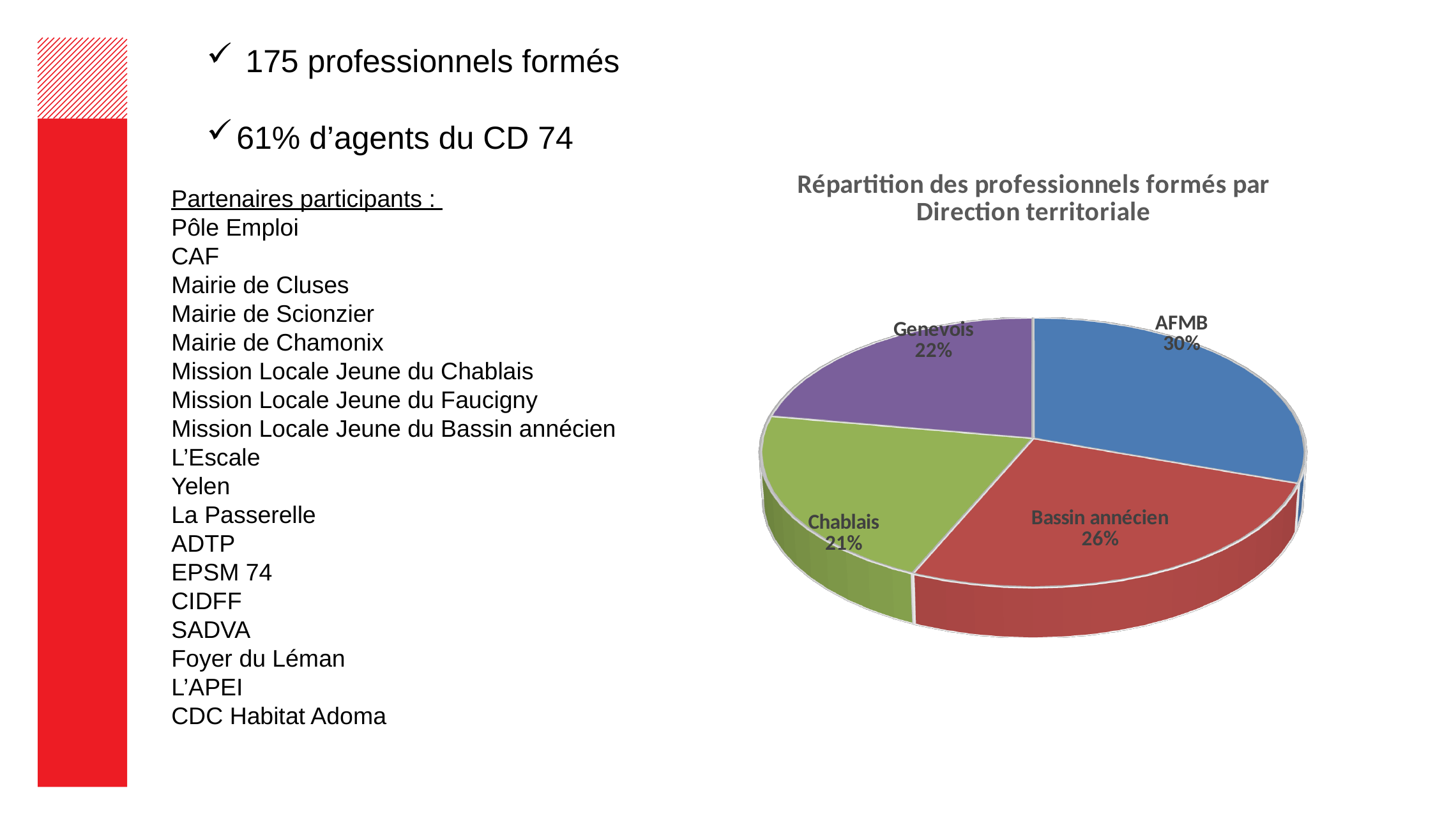
What share of the pie does AFMB represent? 30% What colour is the AFMB slice? Blue What kind of chart is shown on the slide? Pie chart What share of the pie does Bassin annécien represent? 26% Which direction territoriale has the smallest share of the pie? Chablais What share of the pie does Chablais represent? 21% Which is larger, the share for Bassin annécien or the share for Genevois? Bassin annécien What is the title of the chart? Répartition des professionnels formés par Direction territoriale How many slices does the pie chart have? 4 What is the difference in percentage points between AFMB and Chablais? 9 Which direction territoriale has the largest share of the pie? AFMB What share of the pie does Genevois represent? 22%